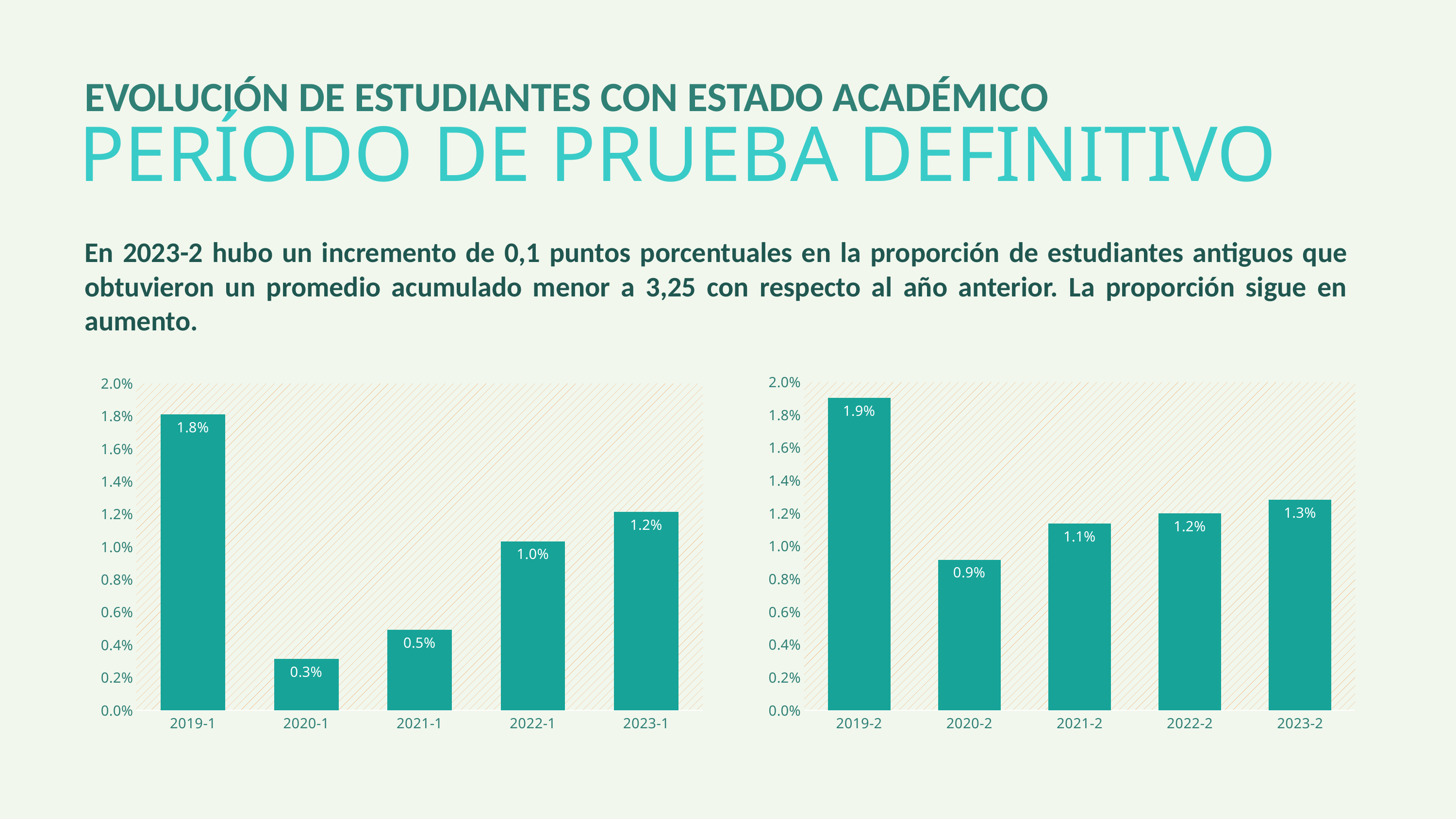
In the left chart, what is the value for 2019-1? 1.8% In the right chart, which period has the highest value? 2019-2 In the left chart, which period has the lowest value? 2020-1 How many periods are shown in the left chart? 5 In the right chart, which is larger, the value for 2020-2 or the value for 2021-2? 2021-2 In the left chart, is the value for 2022-1 greater or less than 0.8%? greater In the left chart, what is the difference between the values for 2019-1 and 2020-1? 1.5% In the right chart, what is the difference between the values for 2023-2 and 2022-2? 0.1% In the left chart, what is the value for 2021-1? 0.5% In the right chart, do the values rise or fall from 2020-2 to 2023-2? rise What kind of chart is the right chart? bar chart In the right chart, what is the value for 2023-2? 1.3%